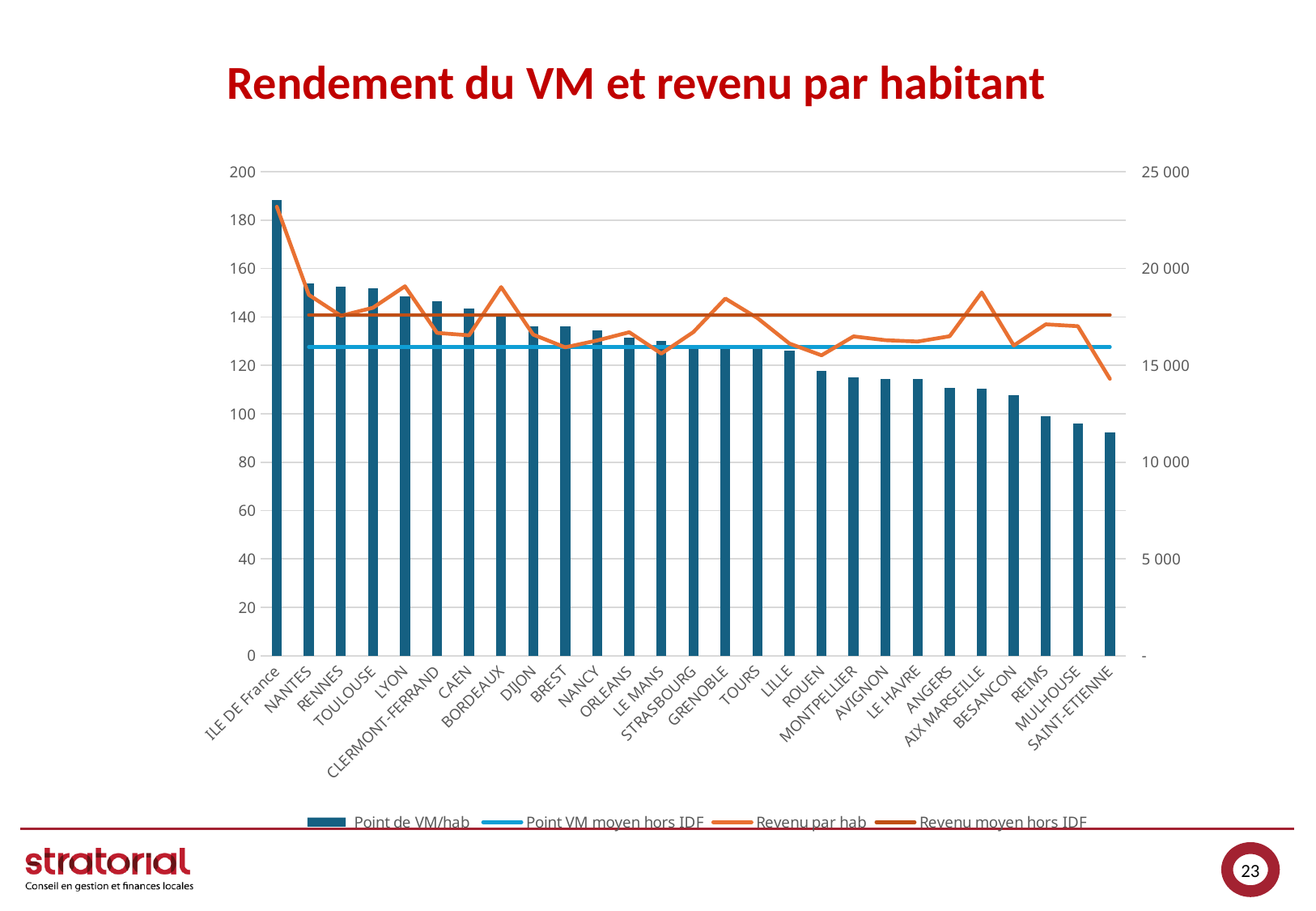
Is the Revenu par hab value for ILE DE France greater or less than 20 000? greater Which category has the lowest Point de VM/hab bar? SAINT-ETIENNE How many series does the legend list? 4 What is the title of the chart? Rendement du VM et revenu par habitant How many cities/categories are shown on the x axis? 27 Is the Point de VM/hab value for NANTES greater or less than 140? greater Is the Point de VM/hab value for SAINT-ETIENNE greater or less than 100? less Which has a higher Point de VM/hab bar, NANTES or SAINT-ETIENNE? NANTES What kind of chart is shown on the slide? A bar chart combined with line series Which category has the highest Point de VM/hab bar? ILE DE France Do the Point de VM/hab bars generally rise or fall from left to right along the x axis? fall